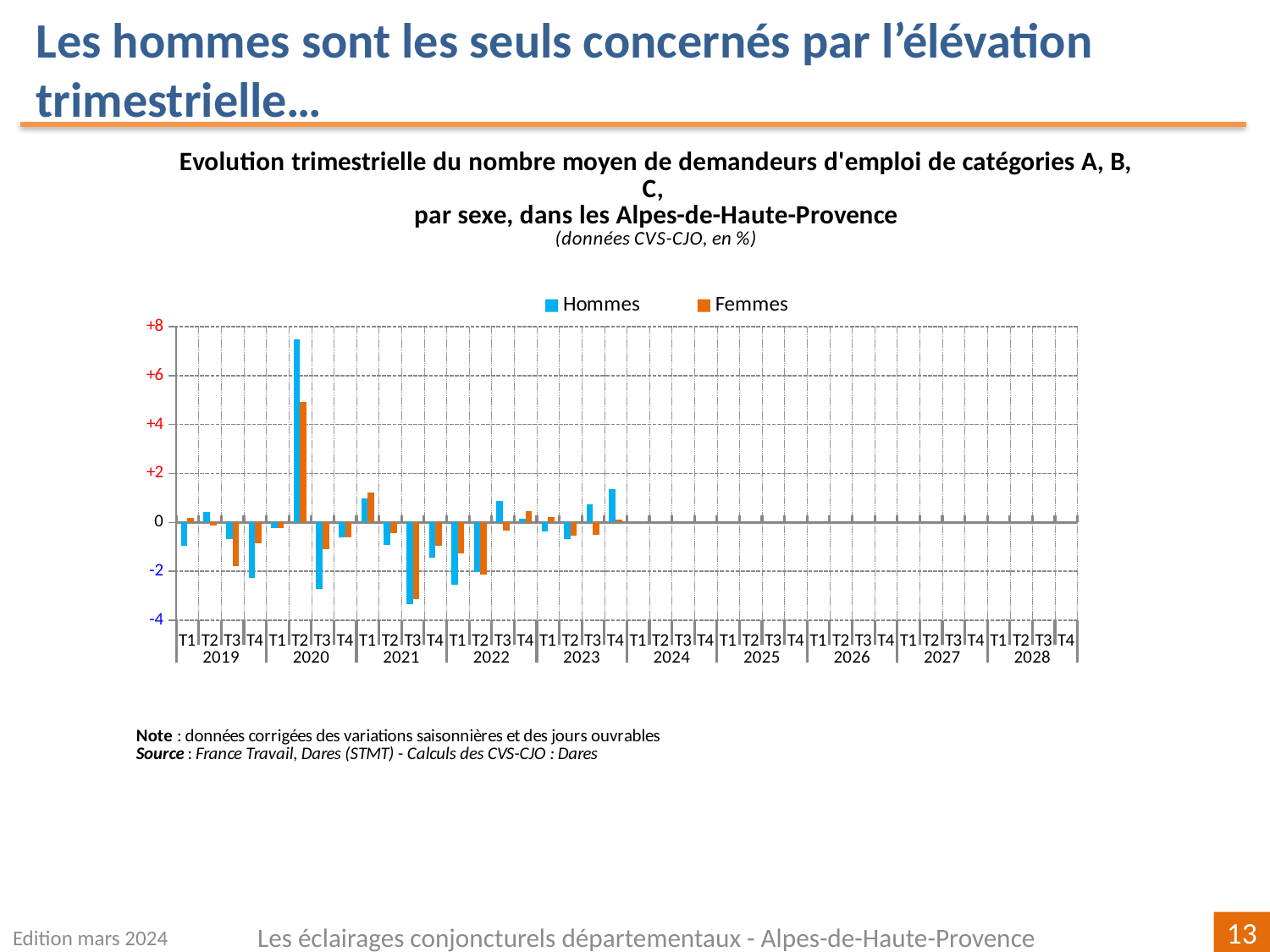
How many series does the legend list? 2 In which quarter is the value for Hommes highest? T2 2020 In T4 2023, which series has the larger value, Hommes or Femmes? Hommes In which quarter is the value for Femmes highest? T2 2020 In T2 2020, which series has the larger value, Hommes or Femmes? Hommes What kind of chart is shown on the slide? bar chart Is the value for Hommes in T2 2020 greater or less than +6? greater Which series are listed in the legend? Hommes and Femmes Is the value for Hommes in T3 2021 greater or less than -2? less How many years are labelled along the x axis? 10 In which quarter is the value for Femmes lowest? T3 2021 Is the value for Femmes in T2 2020 greater or less than +4? greater